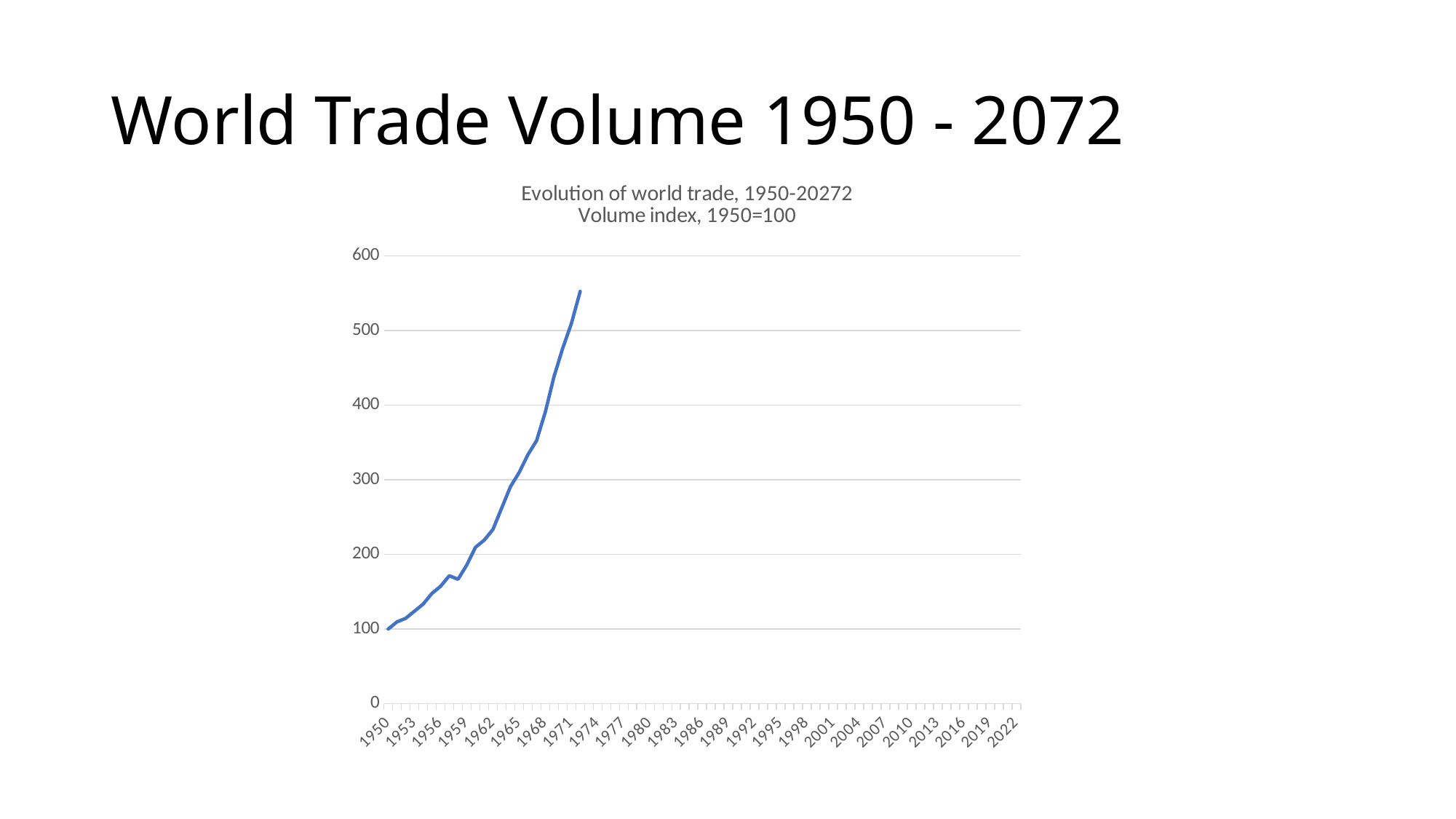
Which is larger, the value for 1965 or the value for 1959? 1965 What is the volume index value for 1950? 100 What is the highest value shown on the vertical axis? 600 Do the values rise or fall along the x axis from 1950 onward? rise What is the title of the chart? Evolution of world trade, 1950-20272 Volume index, 1950=100 Is the value for 1962 greater or less than 200? greater Is the value for 1959 greater or less than 200? less Is the value for 1968 greater or less than 300? greater Which year has the lowest volume index value? 1950 What kind of chart is shown on the slide? line chart